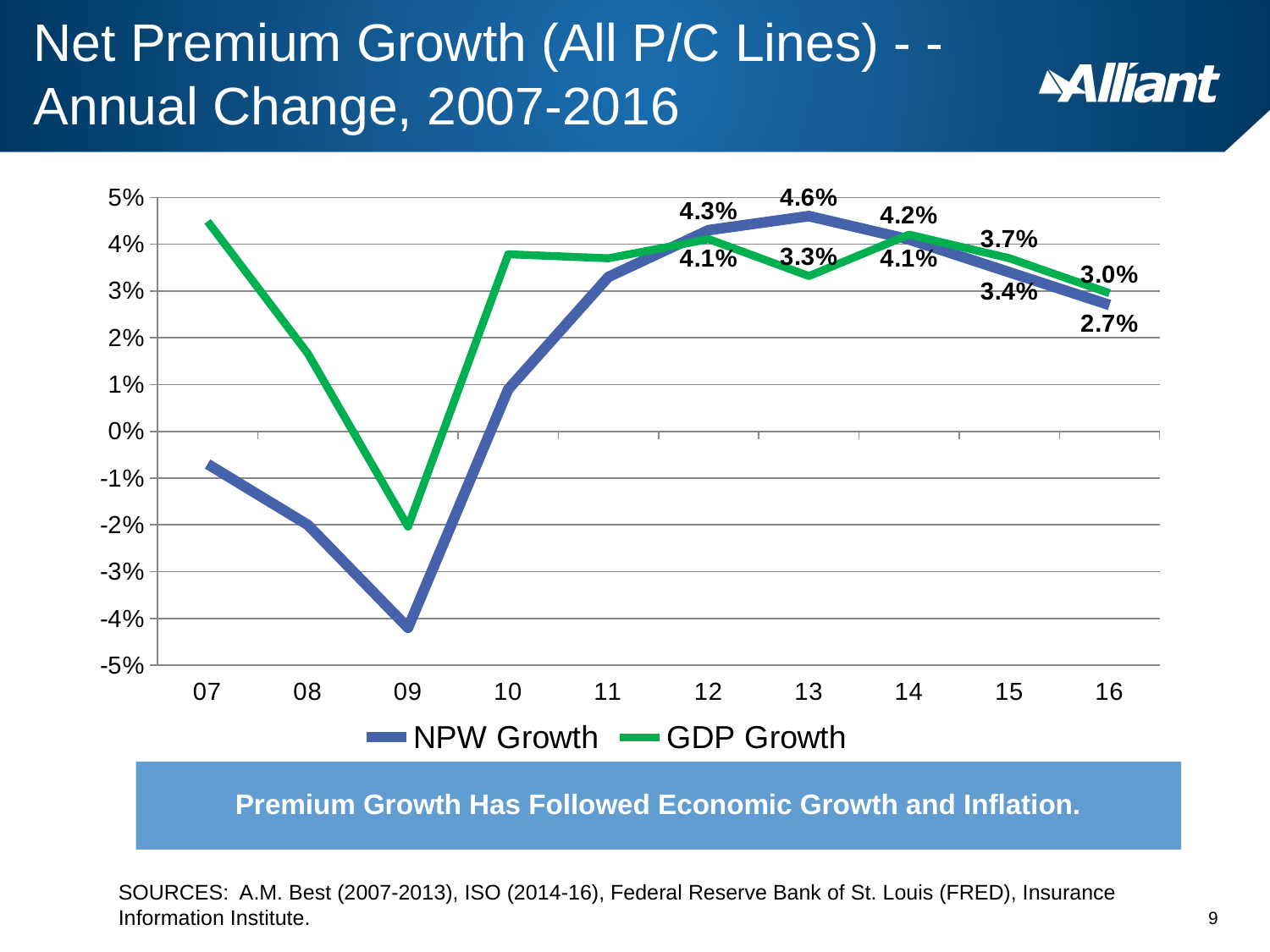
What is the NPW Growth value for 2016? 2.7% What is the difference between NPW Growth and GDP Growth in 2013? 1.3 percentage points What is the GDP Growth value for 2015? 3.7% Which colour is used for the GDP Growth line? Green What is the GDP Growth value for 2013? 3.3% Is the NPW Growth value for 2009 greater or less than -3%? less How many years are plotted along the x axis? 10 In which year is NPW Growth at its lowest? 09 In 2016, which is larger, NPW Growth or GDP Growth? GDP Growth What kind of chart is shown on the slide? Line chart What is the NPW Growth value for 2013? 4.6% How many series does the legend list? 2